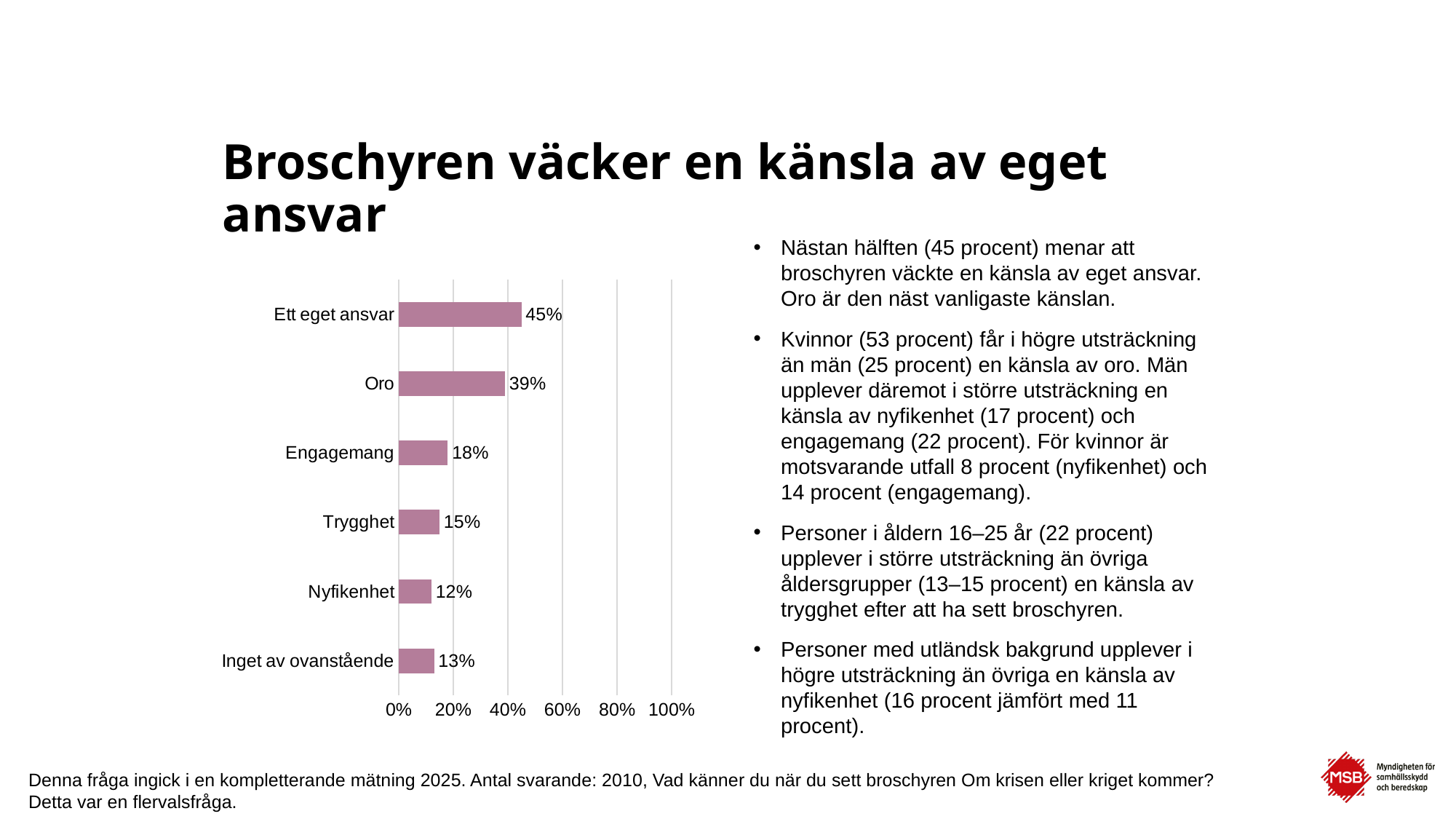
Which category has the highest value? Ett eget ansvar Which category has the lowest value? Nyfikenhet What is the difference between the values for Ett eget ansvar and Oro? 6% What is the value for Nyfikenhet? 12% What is the value for Ett eget ansvar? 45% What is the value for Engagemang? 18% What is the difference between the values for Trygghet and Nyfikenhet? 3% What is the value for Oro? 39% What kind of chart is shown on the slide? bar chart How many categories are shown in the chart? 6 Is the value for Oro greater or less than 40%? less Which is larger, the value for Engagemang or the value for Inget av ovanstående? Engagemang